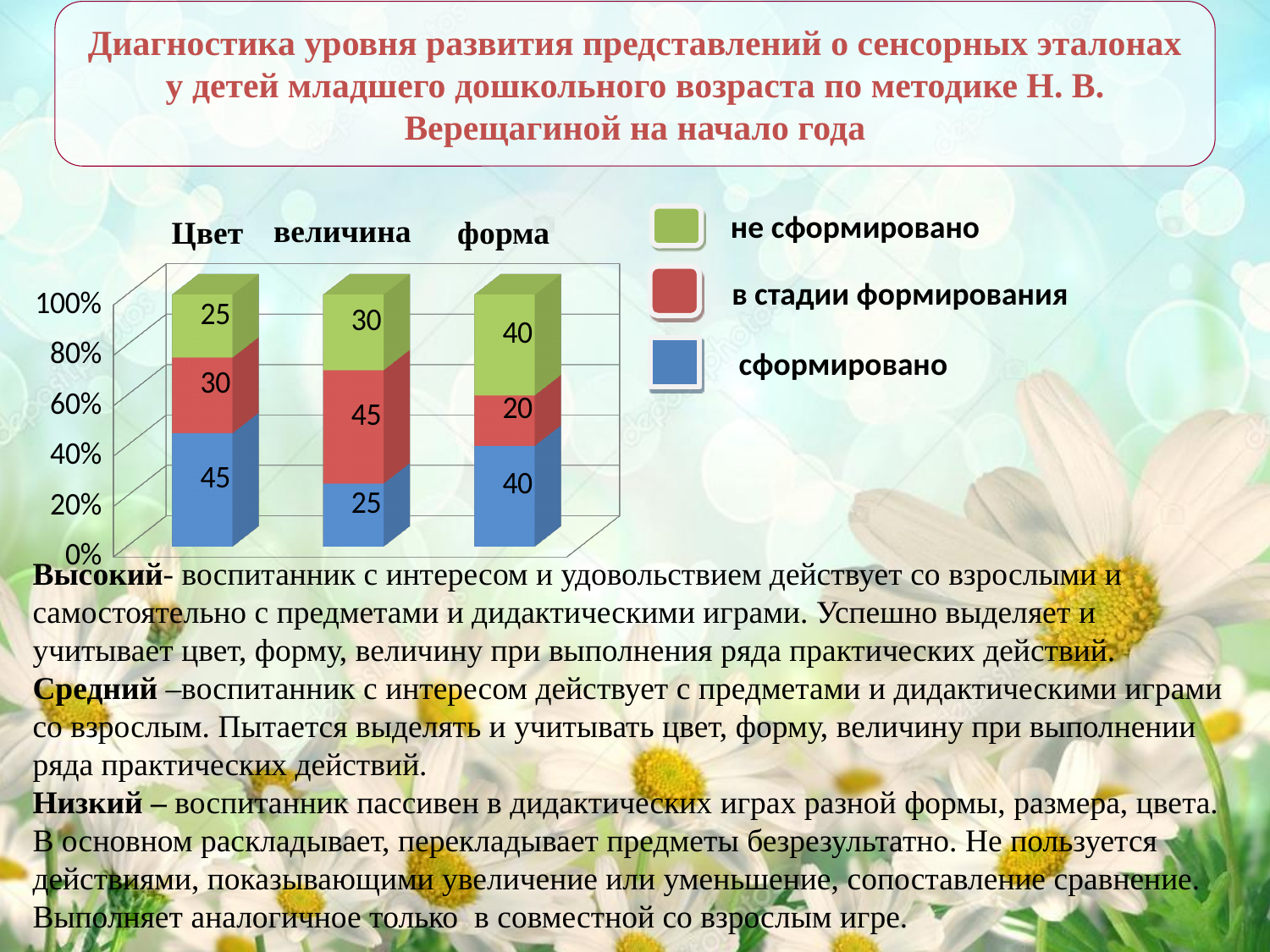
What value is shown for the "в стадии формирования" segment of the "величина" bar? 45 Which category has the highest "не сформировано" value? форма What is the difference between the "сформировано" values for "Цвет" and "величина"? 20 What value is shown for the "сформировано" segment of the "величина" bar? 25 Which is larger: the "не сформировано" value for "Цвет" or for "величина"? величина How many categories are shown on the chart? 3 What value is shown for the "сформировано" segment of the "Цвет" bar? 45 Which colour represents the "сформировано" series in the legend? Blue What value is shown for the "не сформировано" segment of the "форма" bar? 40 What kind of chart is shown on the slide? Stacked bar chart Which category has the lowest "в стадии формирования" value? форма How many series does the legend list? 3